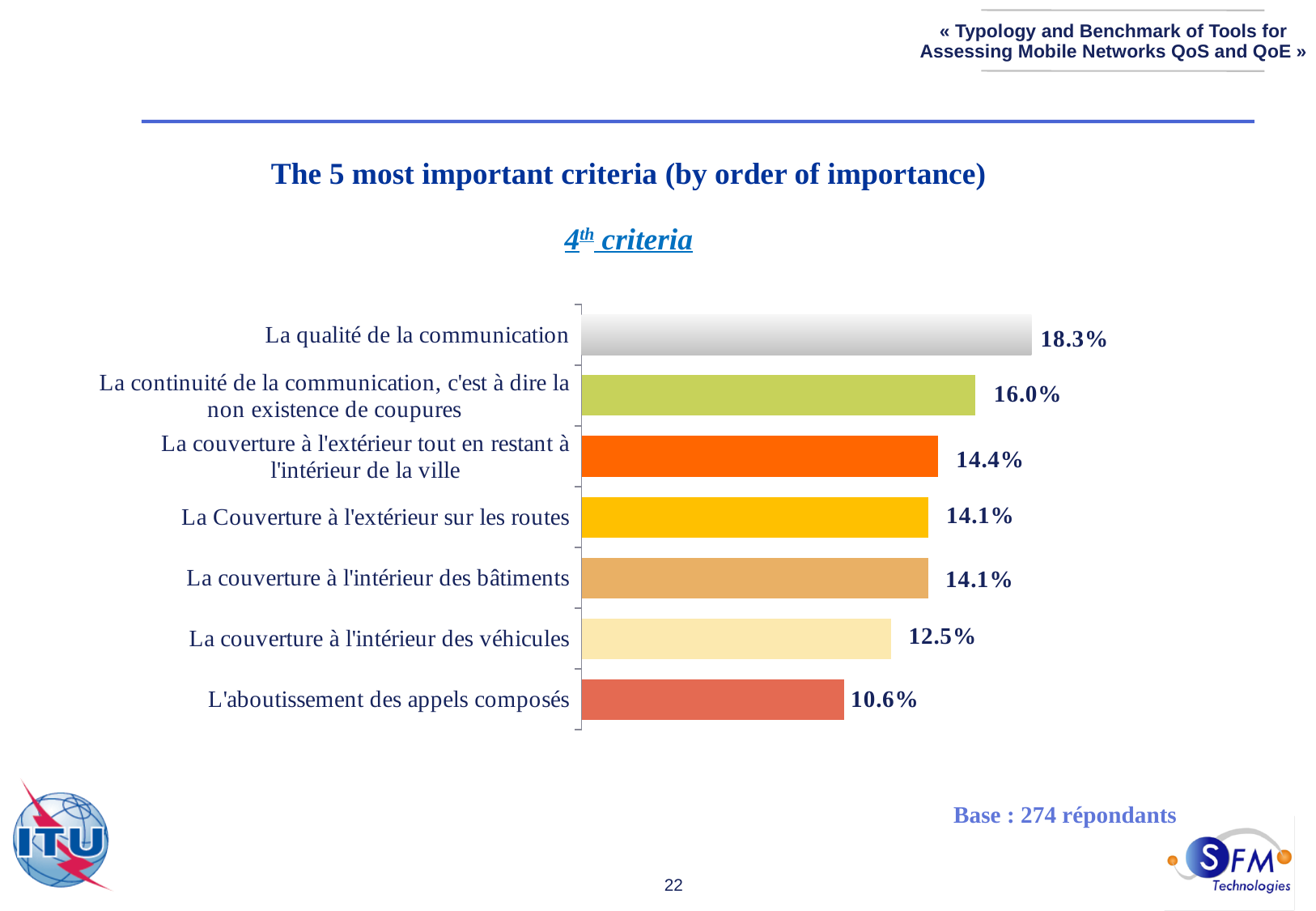
What is the base (number of respondents) stated on the slide? 274 répondants What is the value for "L'aboutissement des appels composés"? 10.6% Which category has the lowest value? L'aboutissement des appels composés What is the value for "La qualité de la communication"? 18.3% How many categories are shown in the chart? 7 What is the difference between the values for "La qualité de la communication" and "La continuité de la communication, c'est à dire la non existence de coupures"? 2.3% What is the value for "La continuité de la communication, c'est à dire la non existence de coupures"? 16.0% What is the value for "La couverture à l'intérieur des véhicules"? 12.5% What is the difference between the values for "La couverture à l'intérieur des véhicules" and "L'aboutissement des appels composés"? 1.9% Which is larger: the value for "La couverture à l'extérieur tout en restant à l'intérieur de la ville" or the value for "La couverture à l'intérieur des véhicules"? La couverture à l'extérieur tout en restant à l'intérieur de la ville Which category has the highest value? La qualité de la communication What kind of chart is shown on the slide? Bar chart